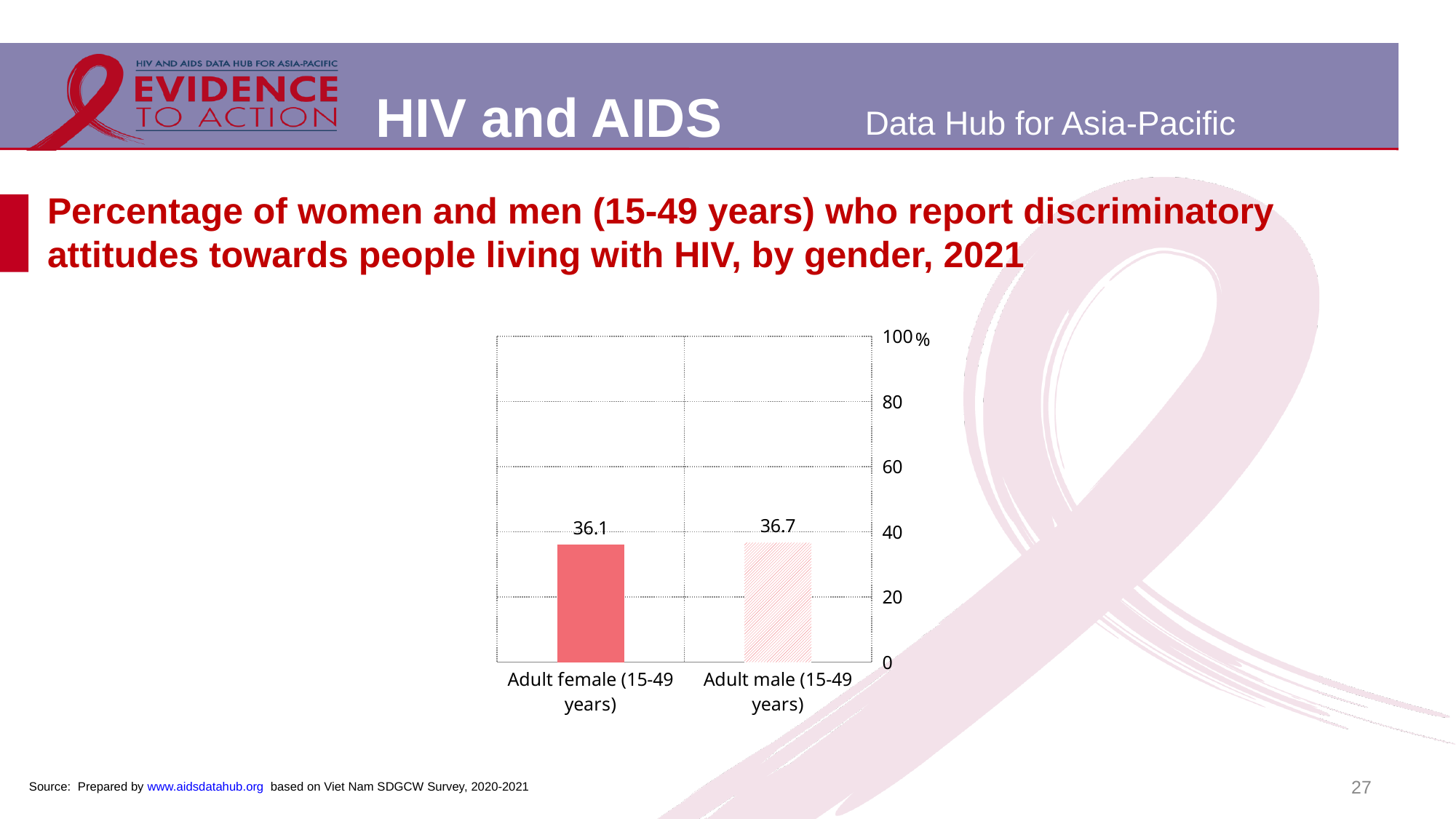
What kind of chart is shown on the slide? Bar chart What unit is indicated at the top of the vertical axis? % What year does the chart title refer to? 2021 Which category has the higher value according to the data labels? Adult male (15-49 years) What is the difference between the values for Adult male (15-49 years) and Adult female (15-49 years)? 0.6 What is the maximum value shown on the vertical axis? 100 What is the value for Adult female (15-49 years)? 36.1 Which category has the lower value according to the data labels? Adult female (15-49 years) Is the value for Adult male (15-49 years) greater or less than 20? greater What is the value for Adult male (15-49 years)? 36.7 Is the value for Adult female (15-49 years) greater or less than 40? less How many categories are shown on the chart? 2